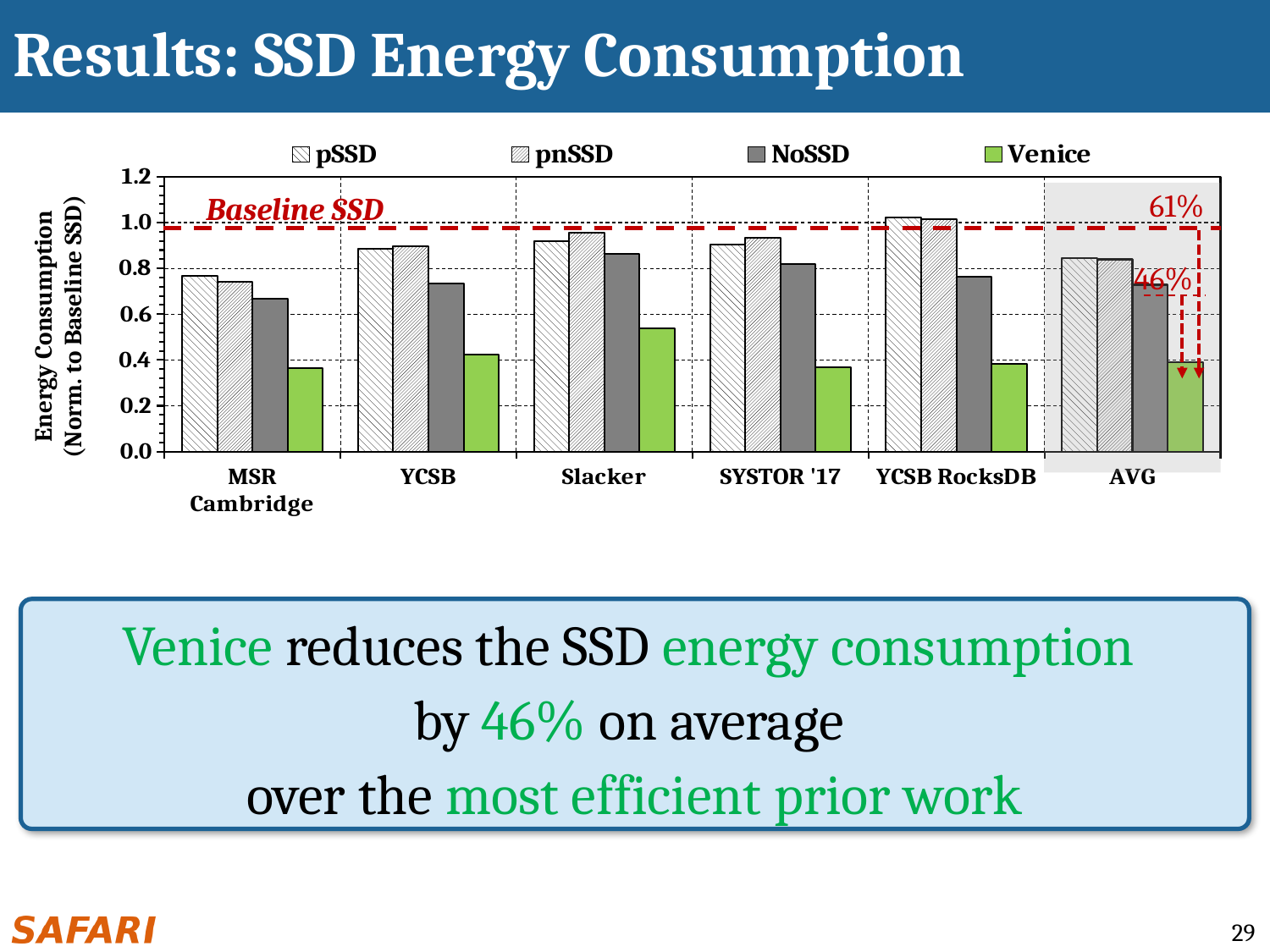
Is the NoSSD value for MSR Cambridge greater or less than 0.6? greater Which is larger: the NoSSD value for Slacker or the NoSSD value for YCSB? Slacker For the pSSD series, which category has the highest energy consumption? YCSB RocksDB What kind of chart is shown on the slide? bar chart Is the Venice value for Slacker greater or less than 0.4? greater For the Venice series, which category has the highest energy consumption? Slacker Is the pSSD value for YCSB greater or less than 1.0? less How many workload categories are shown on the x axis? 6 What percentage reduction is annotated between the NoSSD bar and the Venice bar in the AVG group? 46% Which series has the lowest energy consumption in the AVG group? Venice How many series does the legend list? 4